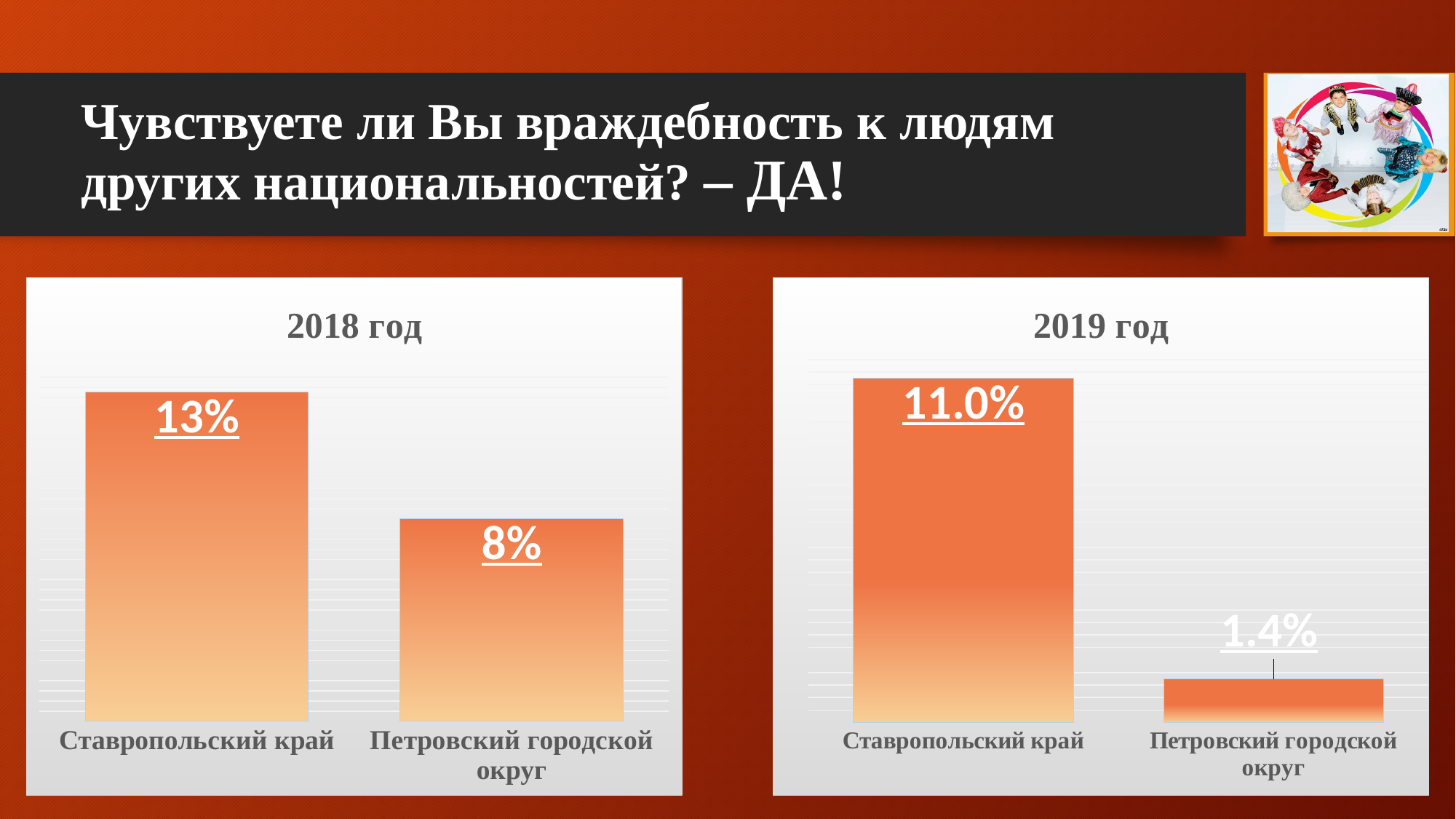
What kind of chart is the "2019 год" chart? Bar chart In the "2019 год" chart, what is the difference between the values for Ставропольский край and Петровский городской округ? 9.6% In the "2019 год" chart, what is the value for Ставропольский край? 11.0% In the "2019 год" chart, which is larger: the value for Ставропольский край or for Петровский городской округ? Ставропольский край In the "2019 год" chart, which category has the lowest value? Петровский городской округ What is the title of the chart on the left side of the slide? 2018 год In the "2018 год" chart, which category has the highest value? Ставропольский край In the "2018 год" chart, what is the value for Ставропольский край? 13% In the "2018 год" chart, what is the difference between the values for Ставропольский край and Петровский городской округ? 5% In the "2019 год" chart, what is the value for Петровский городской округ? 1.4% How many categories are shown in the "2018 год" chart? 2 In the "2018 год" chart, what is the value for Петровский городской округ? 8%